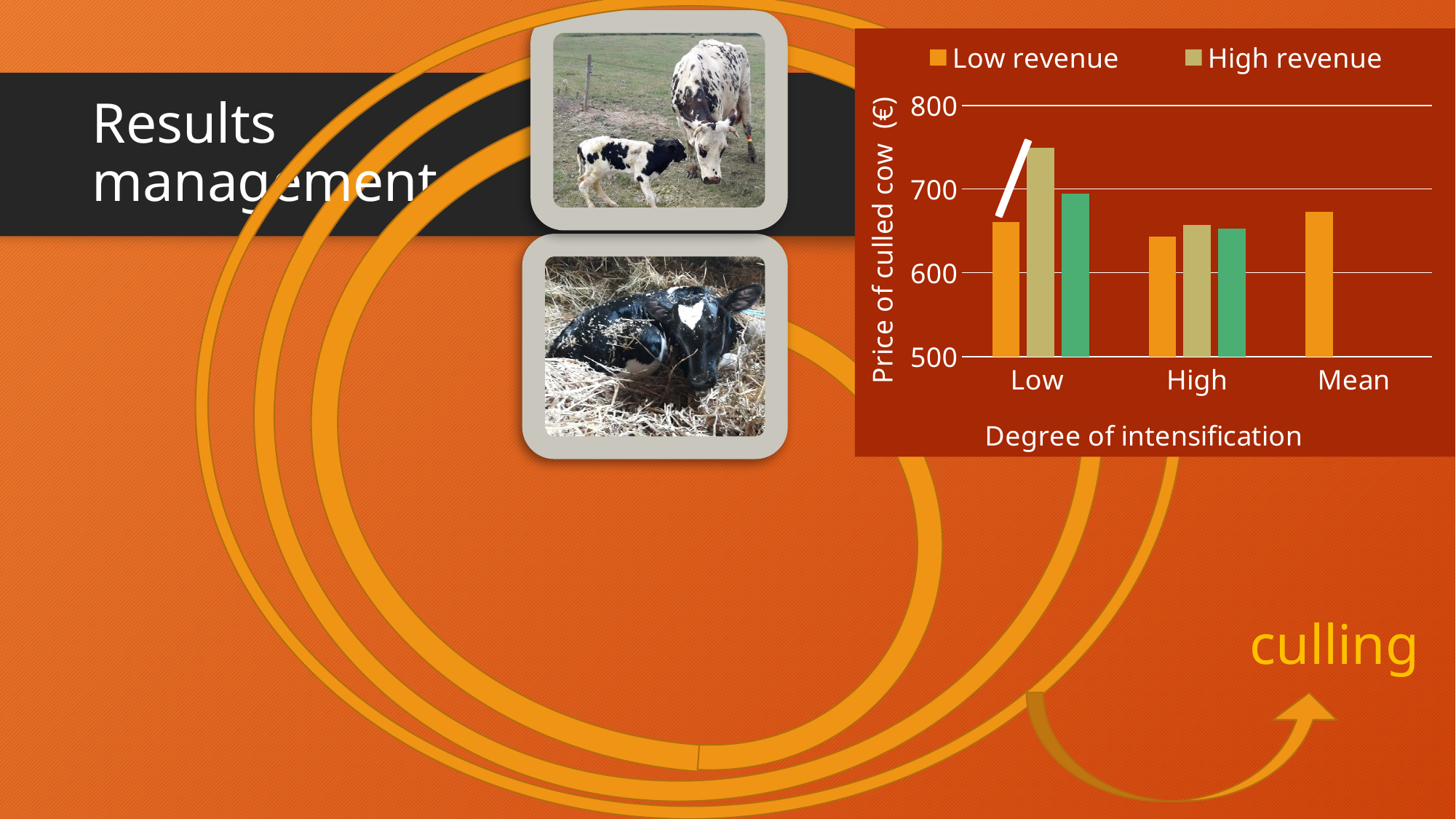
Is the High revenue value for the Low category greater or less than 700? greater For the High revenue series, which category has the highest value? Low Is the Low revenue value for the Mean category greater or less than 650? greater Which category has the lowest Low revenue value? High In the Low category, which is larger: the Low revenue value or the High revenue value? High revenue How many series does the chart legend list? 2 Is the Low revenue value for the Low category greater or less than 700? less What is the title of the x axis of the chart? Degree of intensification What kind of chart is shown on the slide? bar chart What is the title of the y axis of the chart? Price of culled cow (€) How many categories are shown on the x axis of the chart? 3